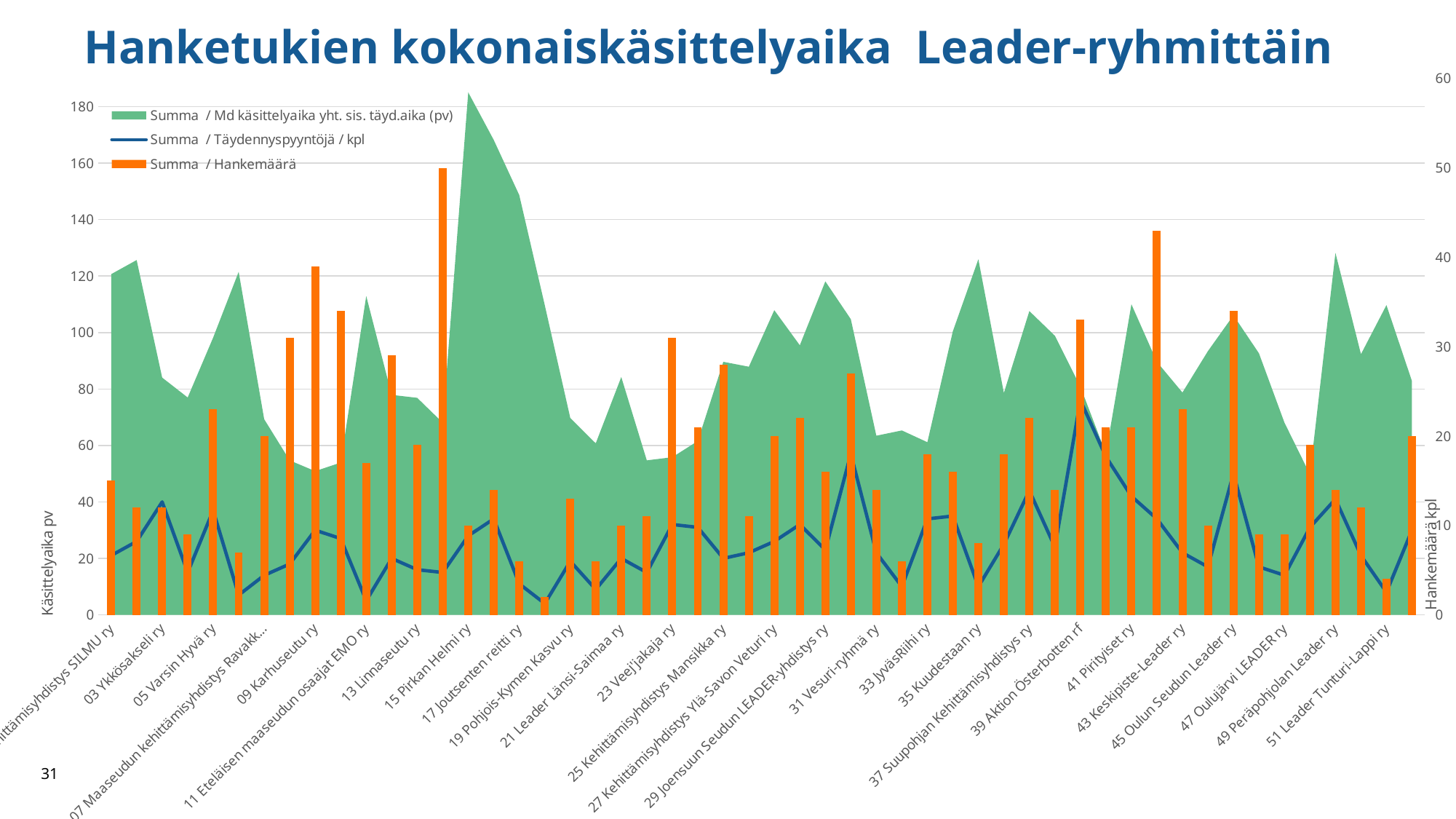
Is the orange Hankemäärä bar for 39 Aktion Österbotten rf greater or less than 30 on the right axis? greater Is the green area value (Md käsittelyaika) for 15 Pirkan Helmi ry greater or less than 160 on the left axis? greater How many series does the legend list? 3 Is the green area value (Md käsittelyaika) for 19 Pohjois-Kymen Kasvu ry greater or less than 80 on the left axis? less Which series is drawn as orange bars? Summa / Hankemäärä Which has the larger green area value (Md käsittelyaika): 15 Pirkan Helmi ry or 19 Pohjois-Kymen Kasvu ry? 15 Pirkan Helmi ry Which Leader group has the highest value in the green area series (Md käsittelyaika yht. sis. täyd.aika)? 15 Pirkan Helmi ry What is the title of the chart? Hanketukien kokonaiskäsittelyaika Leader-ryhmittäin What kind of chart is shown on the slide? A combination chart with an area series, a line series and a bar series Does the green area series rise or fall from 15 Pirkan Helmi ry to 19 Pohjois-Kymen Kasvu ry? fall Which Leader group has the highest value in the blue line series (Täydennyspyyntöjä / kpl)? 39 Aktion Österbotten rf